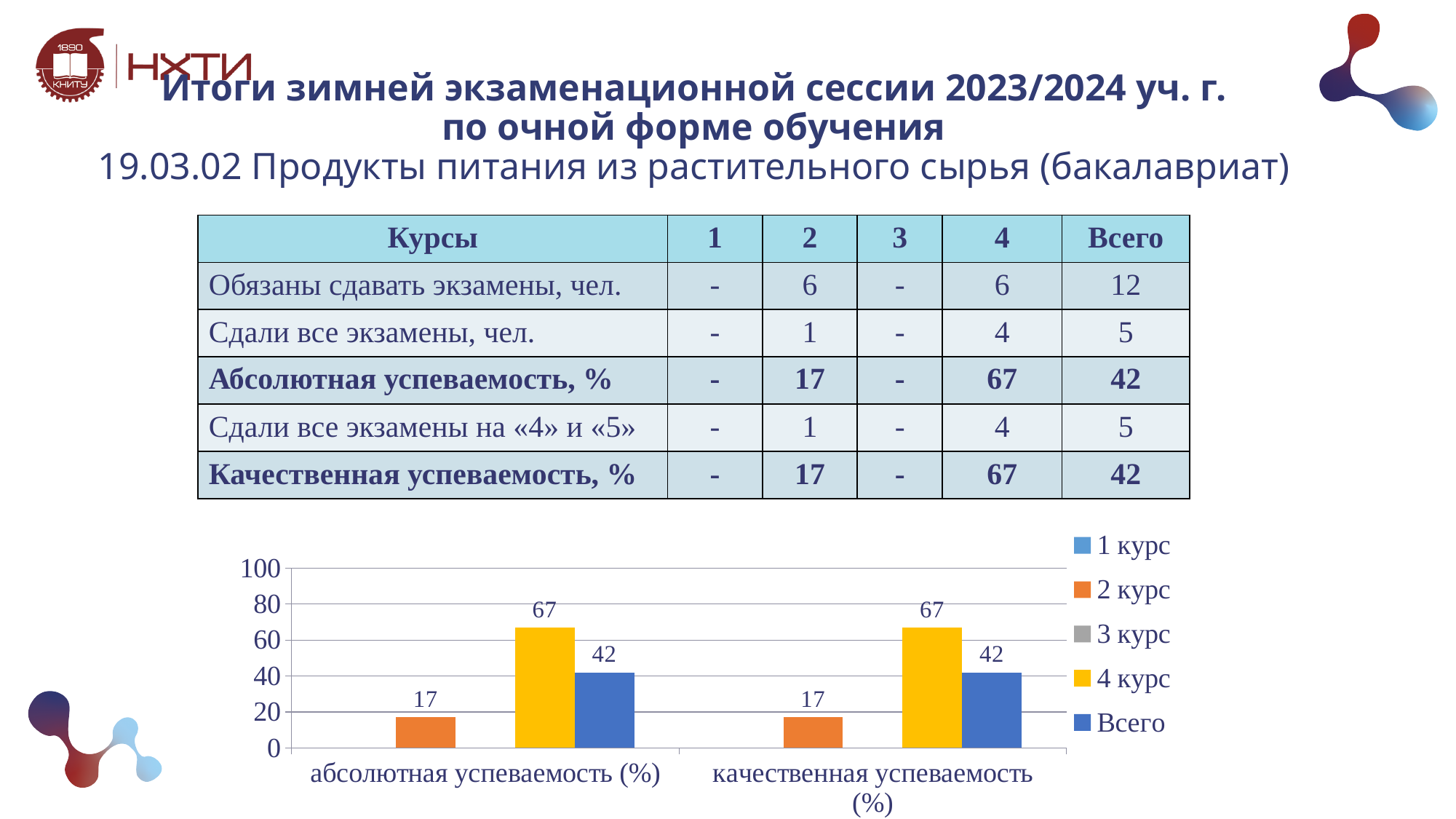
Which is larger in the качественная успеваемость (%) category: the value for 2 курс or the value for Всего? Всего How many series does the chart legend list? 5 Is the value for 4 курс in the качественная успеваемость (%) category greater or less than 60? greater Which series has the lowest plotted value in the абсолютная успеваемость (%) category? 2 курс What is the value for 2 курс in the качественная успеваемость (%) category? 17 How many categories are shown on the x axis of the chart? 2 What is the value for 4 курс in the абсолютная успеваемость (%) category? 67 What type of chart is shown on the slide? bar chart What is the difference between the 4 курс and Всего values in the абсолютная успеваемость (%) category? 25 What is the value for Всего in the абсолютная успеваемость (%) category? 42 Which series has the highest value in the качественная успеваемость (%) category? 4 курс What colour are the bars for 4 курс in the chart? yellow